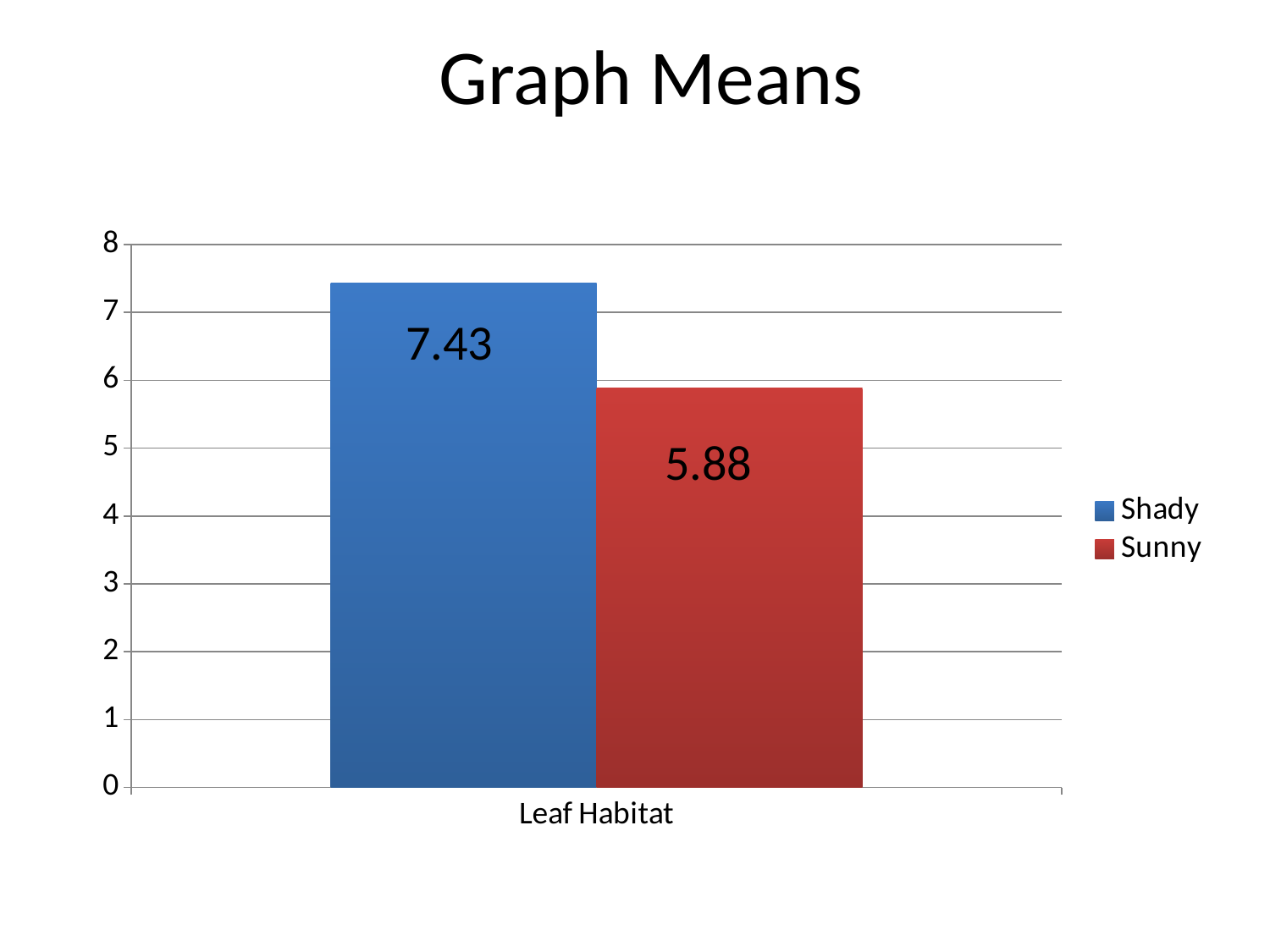
What colour is the Sunny bar? red What is the value for Shady? 7.43 Is the value for Sunny greater or less than 6? less Is the value for Shady greater or less than 7? greater Which series has the lower value? Sunny What kind of chart is shown on the slide? bar chart What is the label on the x axis? Leaf Habitat What is the value for Sunny? 5.88 Is the value for Sunny greater or less than the value for Shady? less How many series does the legend list? 2 Which series has the higher value, Shady or Sunny? Shady What is the difference between the Shady and Sunny values? 1.55